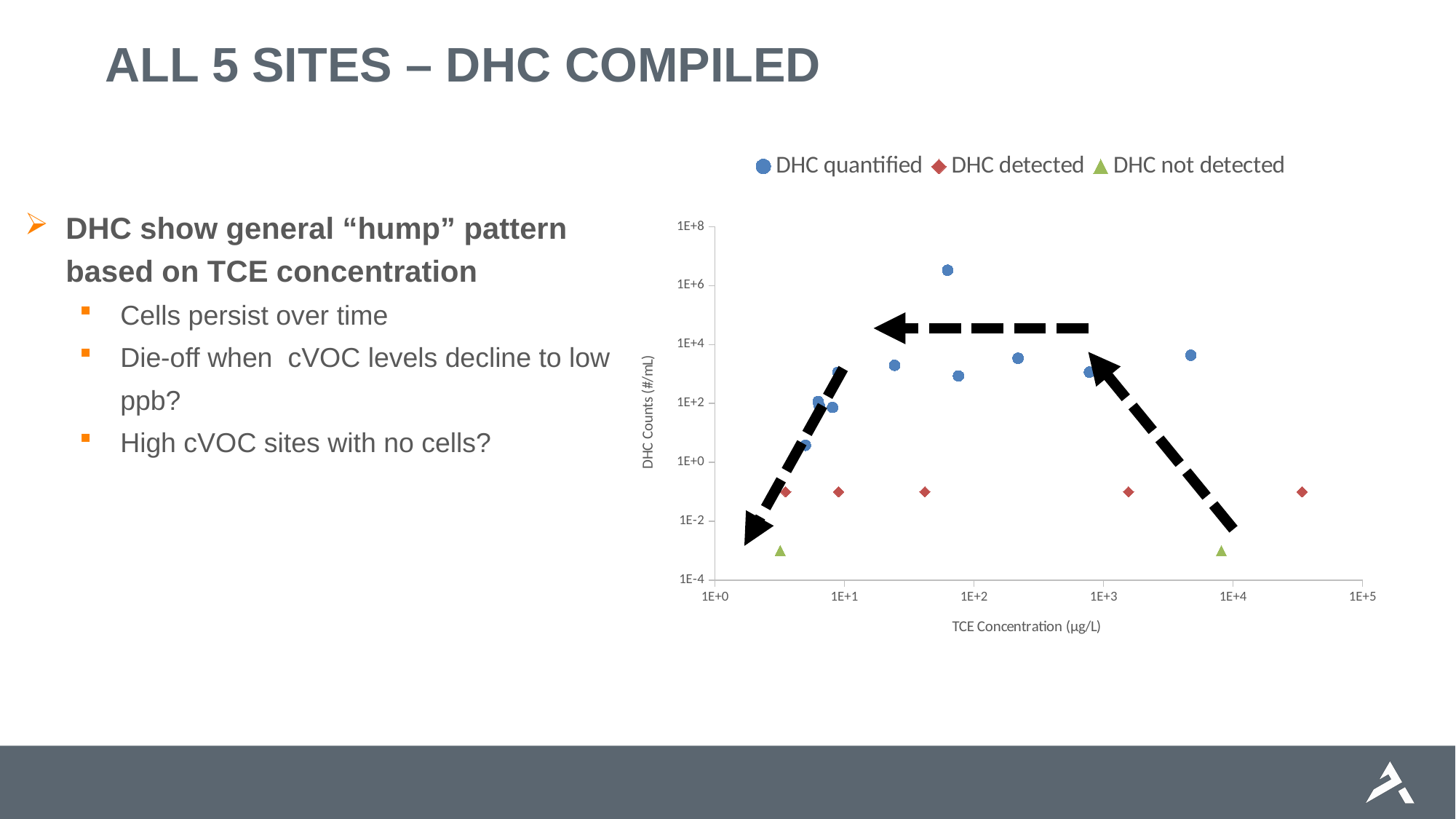
Which series contains the point with the highest DHC count on the chart? DHC quantified What are the three series named in the chart legend? DHC quantified, DHC detected, DHC not detected What is the lowest tick value shown on the y axis of the chart? 1E-4 How many series does the chart legend list? 3 Are the 'DHC not detected' points plotted at DHC counts greater or less than 1E-2? less Is the highest 'DHC quantified' point greater or less than 1E+6 DHC counts? greater How many 'DHC not detected' points (green triangles) are plotted on the chart? 2 What is the title of the chart's x axis? TCE Concentration (µg/L) How many 'DHC detected' points (red diamonds) are plotted on the chart? 5 What kind of chart is shown on the slide? Scatter chart Which series has the lowest plotted DHC counts on the chart? DHC not detected Are the 'DHC detected' points plotted at DHC counts greater or less than 1E+0? less